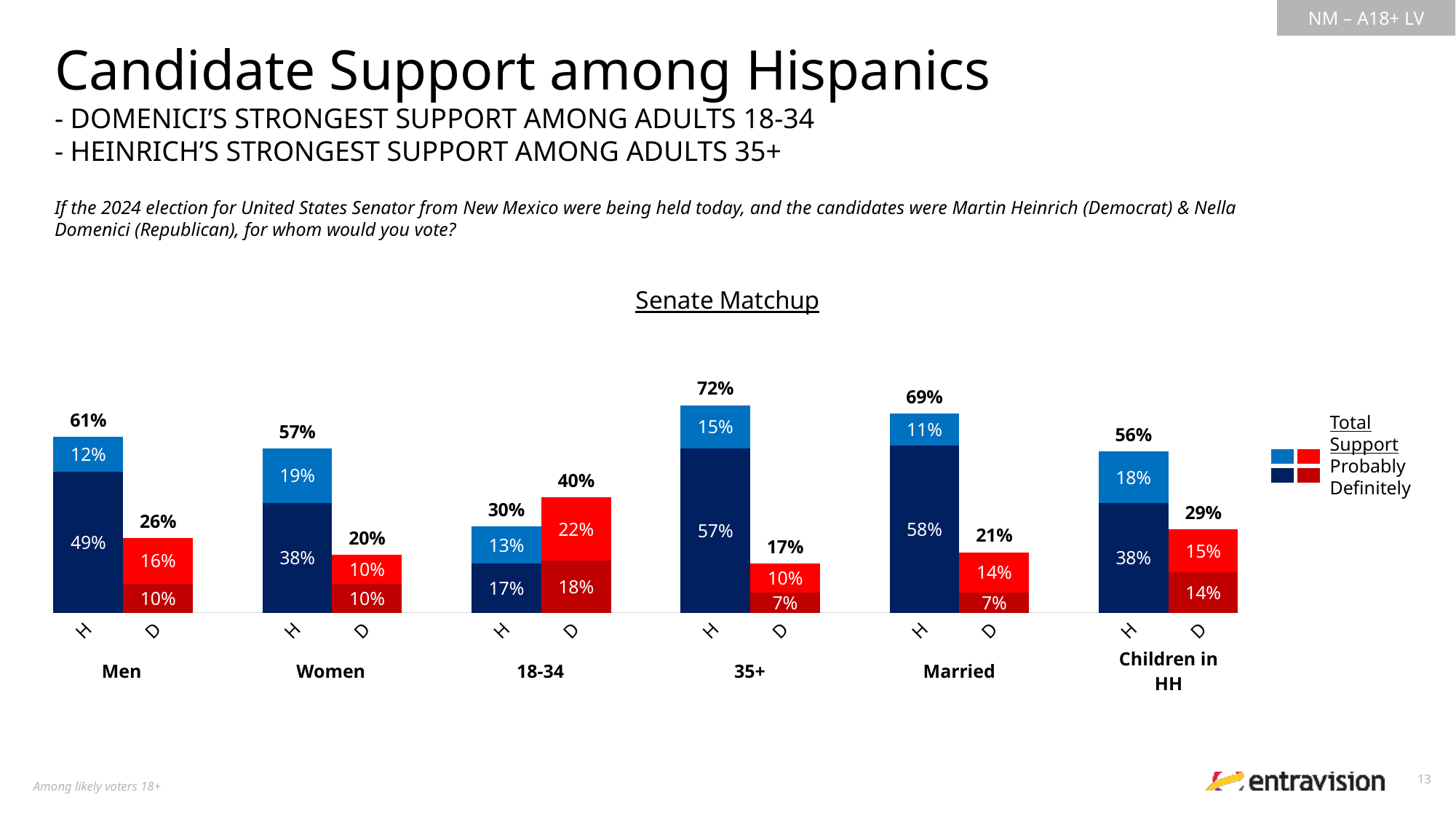
What is the 'Probably' share for Heinrich (H) among Women? 19% Which demographic group shows the highest total support for Heinrich (H)? 35+ What is the total of the stacked bar for Domenici (D) among respondents with Children in HH? 29% Among adults 18-34, which candidate has higher total support, H or D? D Which demographic group shows the lowest total support for Domenici (D)? 35+ How many demographic groups are shown along the x axis? 6 What is the difference between total support for Heinrich (H) and Domenici (D) among Married respondents? 48 percentage points What is the 'Definitely' share for Domenici (D) among adults 18-34? 18% How many series does the legend list? 2 What is the total support for Heinrich (H) among Men? 61% What kind of chart is shown on the slide? Stacked bar chart What is the title of the chart? Senate Matchup